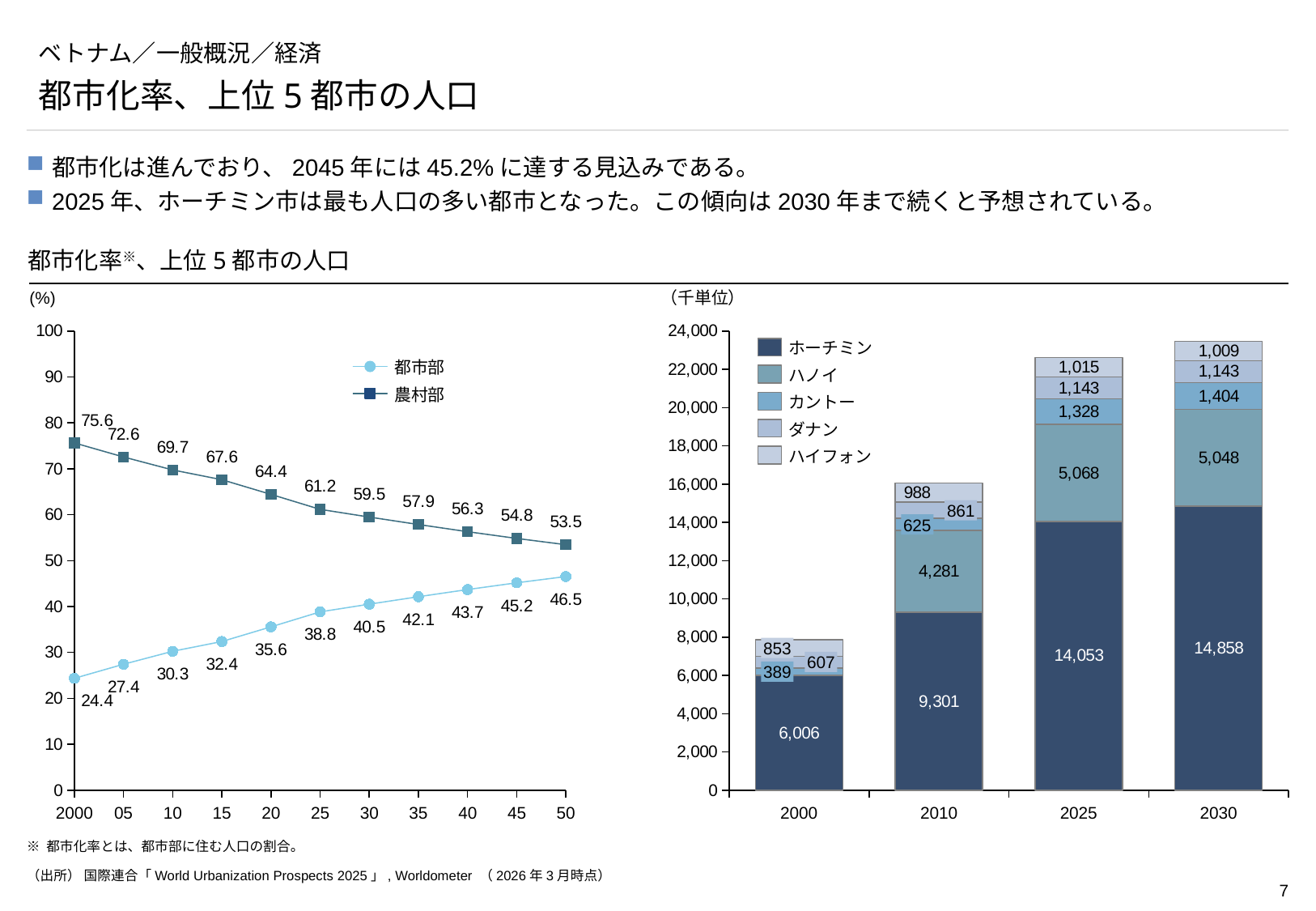
右の上位5都市の人口のグラフで、2010年のハノイと2025年のハノイでは、どちらの値が大きいですか？ 2025年 左の都市化率のグラフで、2050年の農村部と都市部の値の差はいくつですか？ 7.0 左の都市化率のグラフの凡例には、いくつの系列がありますか？ 2 左の都市化率のグラフで、2045年の都市部の値はいくつですか？ 45.2 左の都市化率のグラフで、2000年の農村部の値はいくつですか？ 75.6 左の都市化率のグラフは、どの種類のグラフですか？ 折れ線グラフ 左の都市化率のグラフで、都市部の値は年とともに上昇していますか、下降していますか？ 上昇 右の上位5都市の人口のグラフで、2030年のホーチミンの値はいくつですか？ 14,858 右の上位5都市の人口のグラフで、2000年の積み上げ棒の合計は8,000より大きいですか、小さいですか？ 小さい 右の上位5都市の人口のグラフで、2025年の積み上げ棒の合計はいくつですか？ 22,607 右の上位5都市の人口のグラフの凡例には、いくつの都市が示されていますか？ 5 右の上位5都市の人口のグラフで、2025年のカントーの値はいくつですか？ 1,328